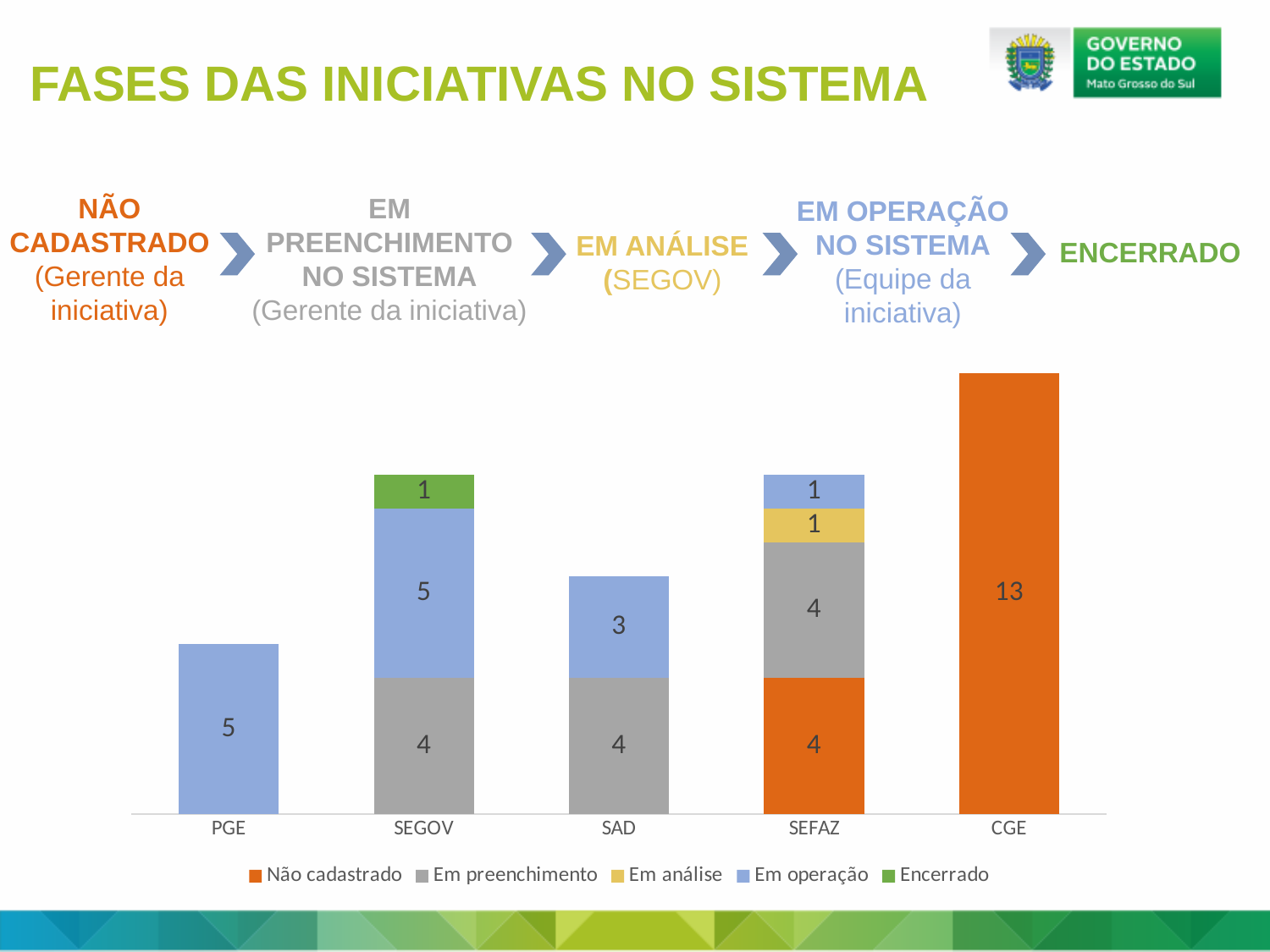
How many categories are shown on the x axis? 5 Which category has the highest total bar? CGE What kind of chart is shown on the slide? stacked bar chart What is the difference between the 'Em operação' values for SEGOV and SAD? 2 What is the value of 'Em preenchimento' for SAD? 4 How many series does the legend list? 5 What is the value of 'Encerrado' for SEGOV? 1 What is the value of 'Não cadastrado' for CGE? 13 What is the total of the stacked bar for SEGOV? 10 What is the value of 'Em operação' for PGE? 5 What is the total of the stacked bar for SEFAZ? 10 What is the value of 'Em análise' for SEFAZ? 1